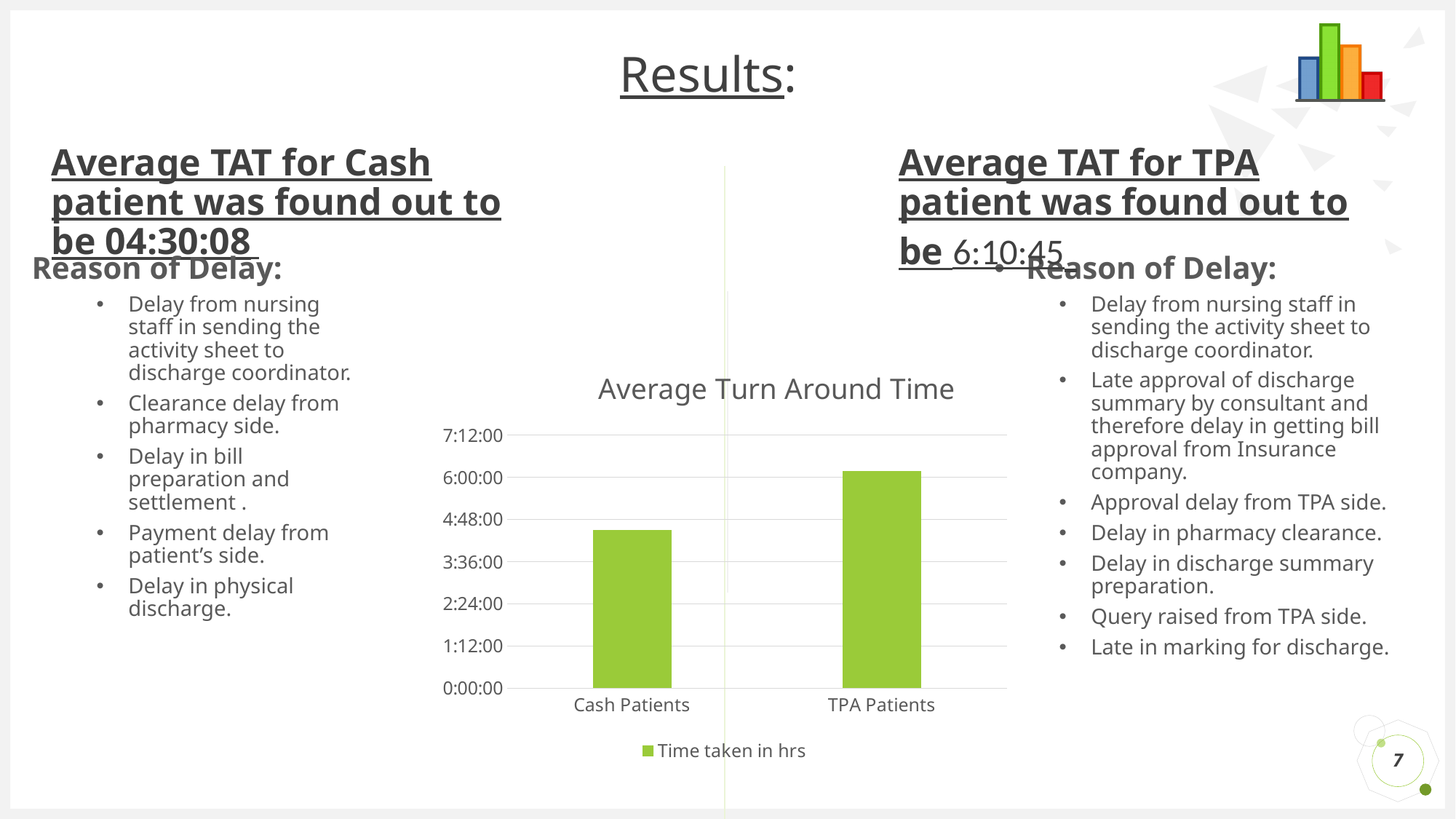
Is the value for Cash Patients greater or less than 3:36:00? greater Which category has the highest value in the chart? TPA Patients Do the values rise or fall from Cash Patients to TPA Patients along the x axis? rise What is the name of the series in the chart legend? Time taken in hrs Which category has the lowest value in the chart? Cash Patients Which is larger, the value for Cash Patients or the value for TPA Patients? TPA Patients Is the value for Cash Patients greater or less than 4:48:00? less How many categories are shown on the x axis of the chart? 2 Is the value for TPA Patients greater or less than 4:48:00? greater What kind of chart is shown on the slide? bar chart What is the title of the chart? Average Turn Around Time How many series does the chart legend list? 1